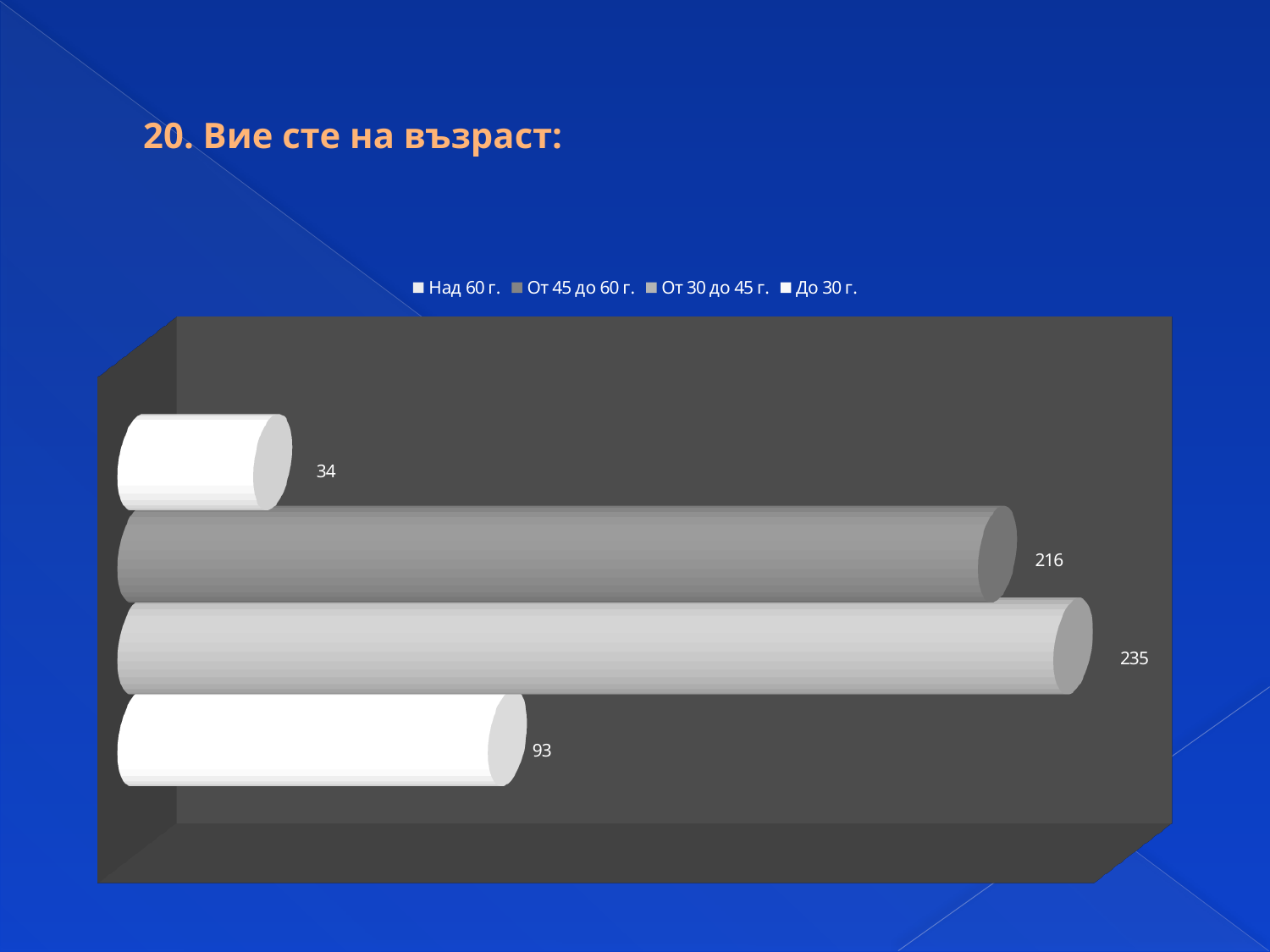
Which is larger: the value on the bottom bar or the value on the topmost bar? the bottom bar (93) What type of chart is shown on the slide? bar chart What is the lowest value shown on any bar in the chart? 34 How many entries does the chart legend list? 4 What is the difference between the largest bar value (235) and the smallest bar value (34)? 201 How many bars are plotted in the chart? 4 What is the value labelled on the bottom bar of the chart? 93 What is the highest value shown on any bar in the chart? 235 What is the difference between the two longest bars, labelled 235 and 216? 19 What is the title of the slide containing the chart? 20. Вие сте на възраст: What is the value labelled on the topmost bar of the chart? 34 What is the value labelled on the second bar from the top? 216